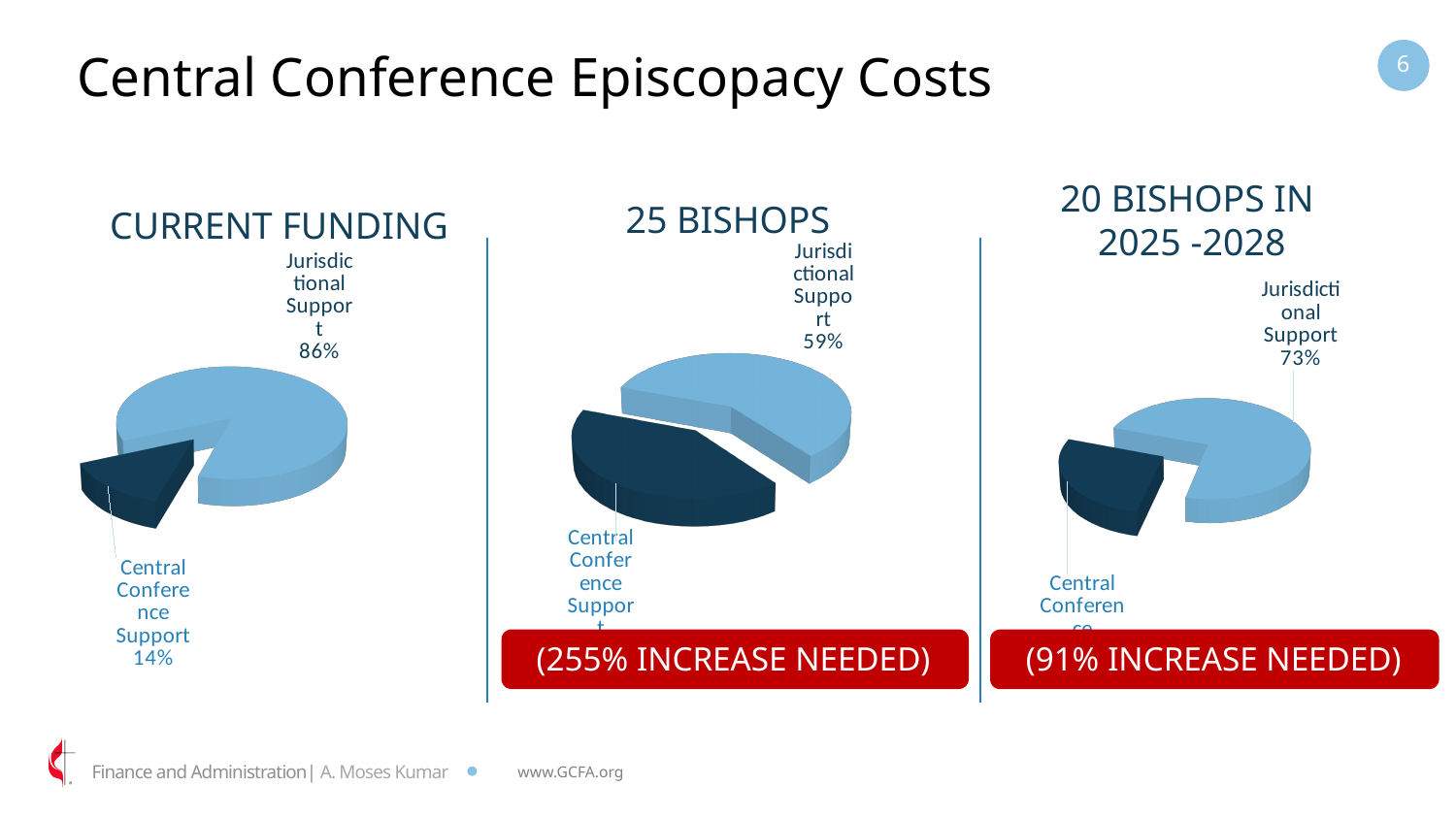
In the CURRENT FUNDING chart, what is the difference in percentage points between Jurisdictional Support and Central Conference Support? 72 percentage points In the 20 BISHOPS IN 2025-2028 chart, what share of the pie is Jurisdictional Support? 73% In the CURRENT FUNDING chart, which slice is the largest? Jurisdictional Support How many pie charts are shown on the slide? 3 In the 25 BISHOPS chart, which slice is larger, Jurisdictional Support or Central Conference Support? Jurisdictional Support In the CURRENT FUNDING chart, what share of the pie is Jurisdictional Support? 86% In the 25 BISHOPS chart, what share of the pie is Jurisdictional Support? 59% In the 20 BISHOPS IN 2025-2028 chart, which slice is the smallest? Central Conference Support Which chart shows a larger Jurisdictional Support share, 25 BISHOPS or 20 BISHOPS IN 2025-2028? 20 BISHOPS IN 2025-2028 How many slices does the 25 BISHOPS pie chart have? 2 What kind of chart is the CURRENT FUNDING chart? Pie chart